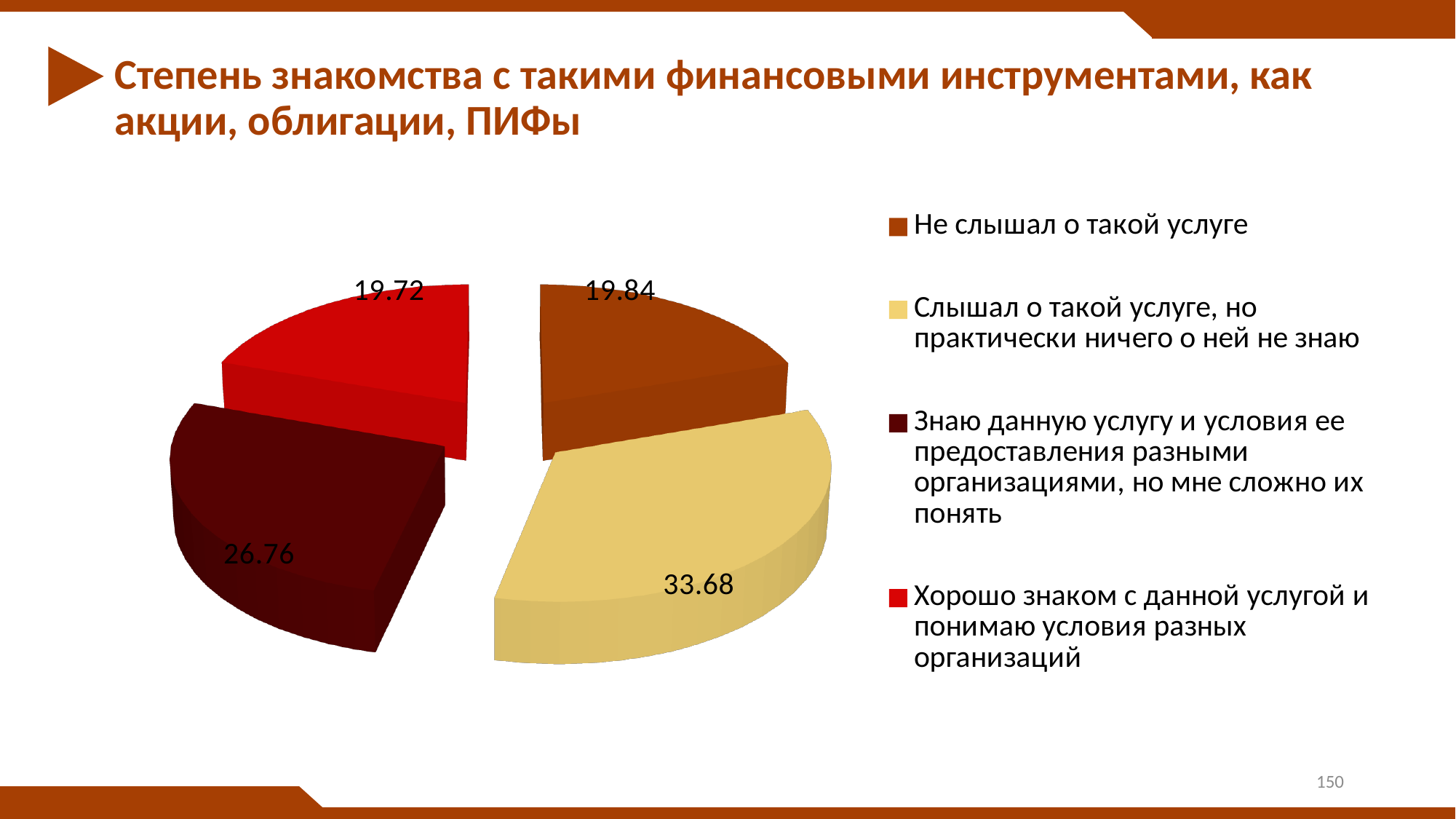
What is the difference between the values for "Слышал о такой услуге, но практически ничего о ней не знаю" and "Знаю данную услугу и условия ее предоставления разными организациями, но мне сложно их понять"? 6.92 What is the difference between the values for "Слышал о такой услуге, но практически ничего о ней не знаю" and "Не слышал о такой услуге"? 13.84 What value is shown for the slice "Хорошо знаком с данной услугой и понимаю условия разных организаций"? 19.72 Which category has the largest slice of the pie? Слышал о такой услуге, но практически ничего о ней не знаю What kind of chart is shown on the slide? Pie chart What value is shown for the slice "Слышал о такой услуге, но практически ничего о ней не знаю"? 33.68 Which is larger: the value for "Знаю данную услугу и условия ее предоставления разными организациями, но мне сложно их понять" or the value for "Не слышал о такой услуге"? Знаю данную услугу и условия ее предоставления разными организациями, но мне сложно их понять What colour is the slice for "Слышал о такой услуге, но практически ничего о ней не знаю"? Yellow What value is shown for the slice "Знаю данную услугу и условия ее предоставления разными организациями, но мне сложно их понять"? 26.76 Which category has the smallest slice of the pie? Хорошо знаком с данной услугой и понимаю условия разных организаций What value is shown for the slice "Не слышал о такой услуге"? 19.84 How many slices does the pie chart have? 4